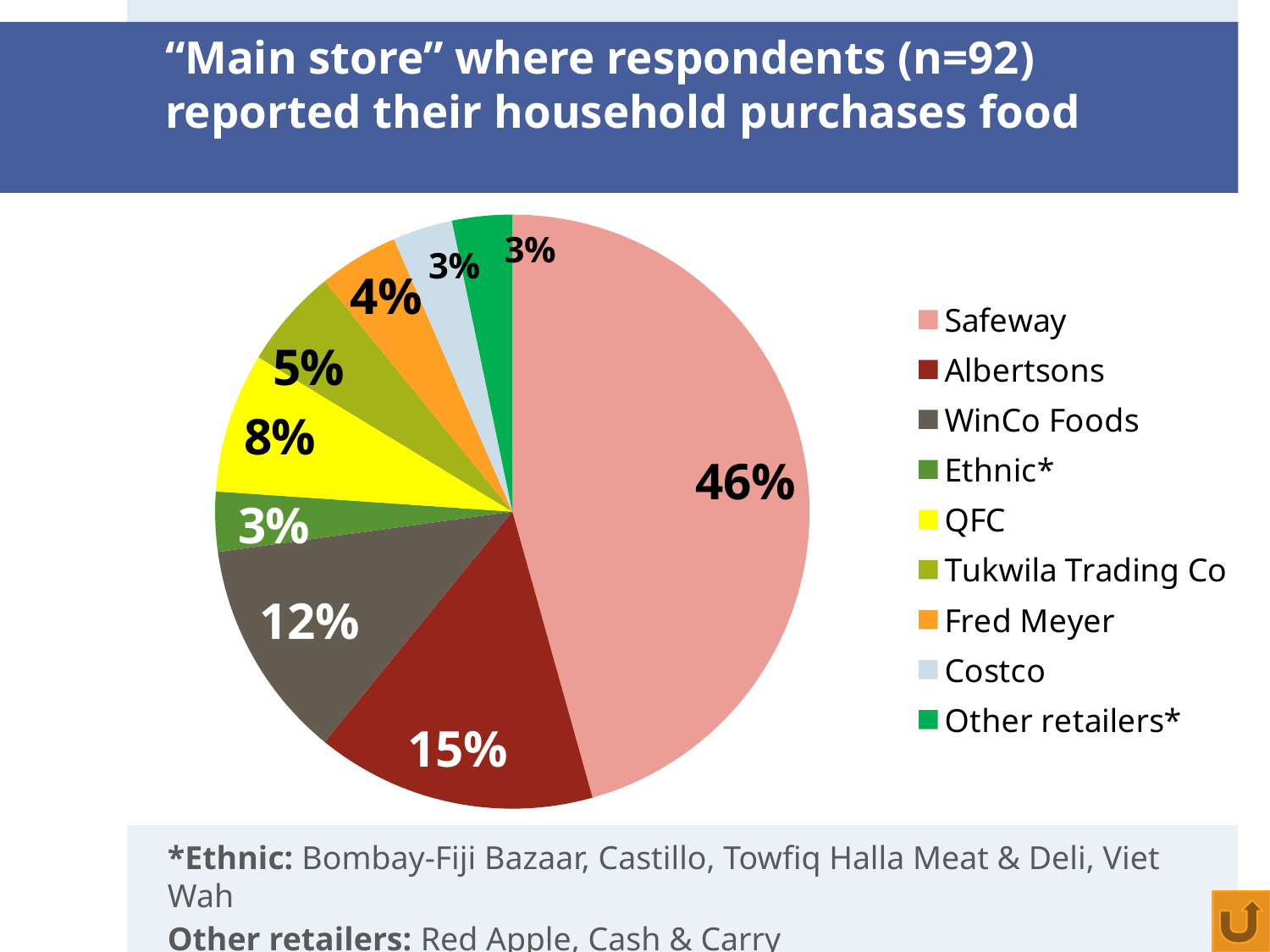
What share does Tukwila Trading Co have in the pie chart? 5% What percentage is shown for Fred Meyer? 4% What share of respondents reported Safeway as their main store? 46% Which store has the largest slice of the pie chart? Safeway What is the value shown for WinCo Foods? 12% How many store categories does the legend list? 9 What is the sample size (n) stated in the chart title? 92 What is the difference in percentage points between Safeway and Albertsons? 31 What percentage is shown for QFC? 8% Which has a larger share, WinCo Foods or QFC? WinCo Foods What percentage of the pie is labelled for Albertsons? 15% What type of chart is shown on the slide? Pie chart